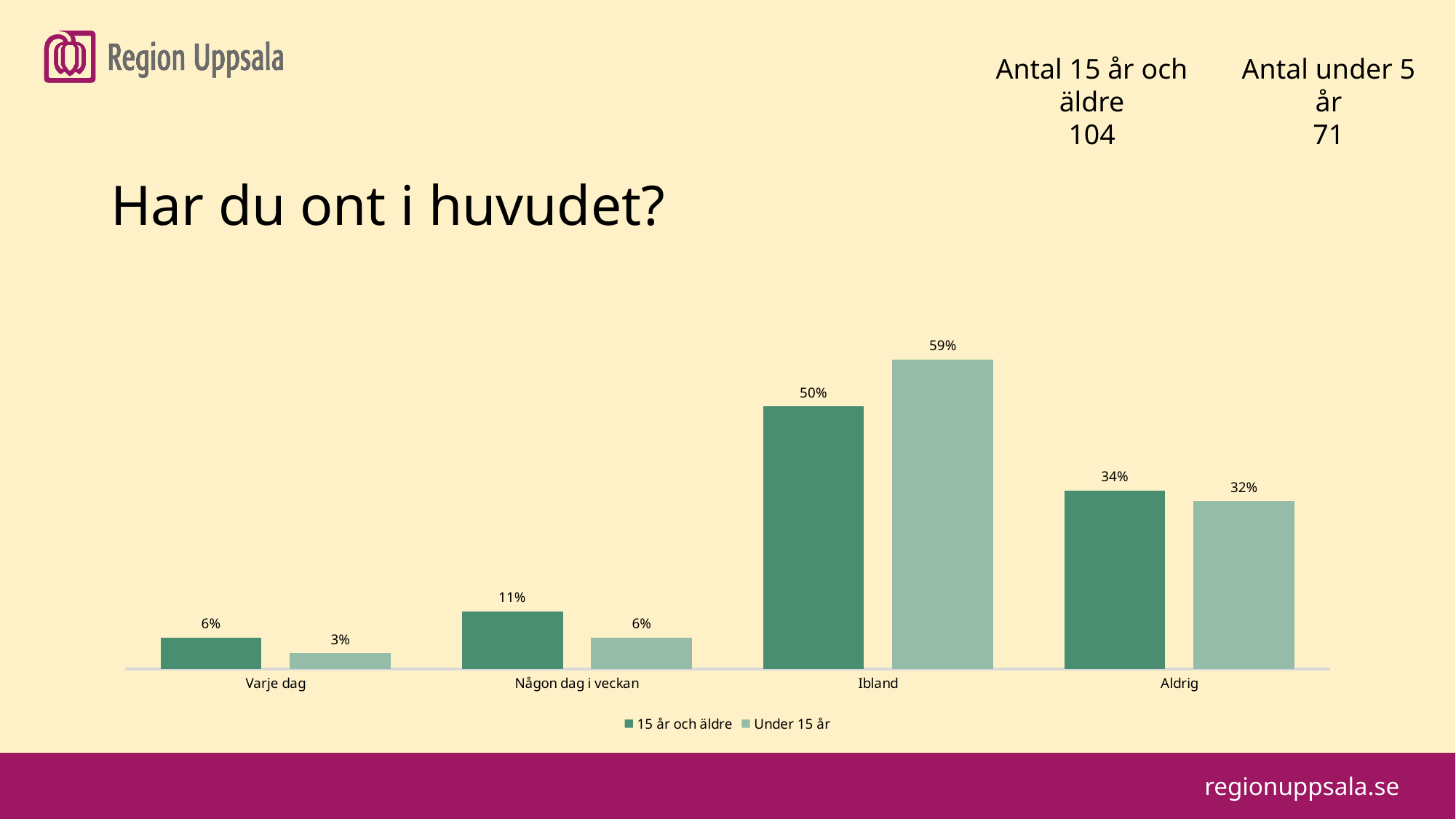
What is the title of the slide above the chart? Har du ont i huvudet? What kind of chart is shown on the slide? Bar chart How many series does the legend list? 2 Which category has the lowest value for the "15 år och äldre" series? Varje dag What is the value for "15 år och äldre" in the "Ibland" category? 50% What is the value for "Under 15 år" in the "Varje dag" category? 3% What is the difference between the "Under 15 år" and "15 år och äldre" values in the "Ibland" category? 9% Which category has the highest value for the "Under 15 år" series? Ibland What is the value for "Under 15 år" in the "Aldrig" category? 32% In the "Aldrig" category, which series has the larger value: "15 år och äldre" or "Under 15 år"? 15 år och äldre How many categories are shown on the x axis? 4 What is the value for "15 år och äldre" in the "Någon dag i veckan" category? 11%